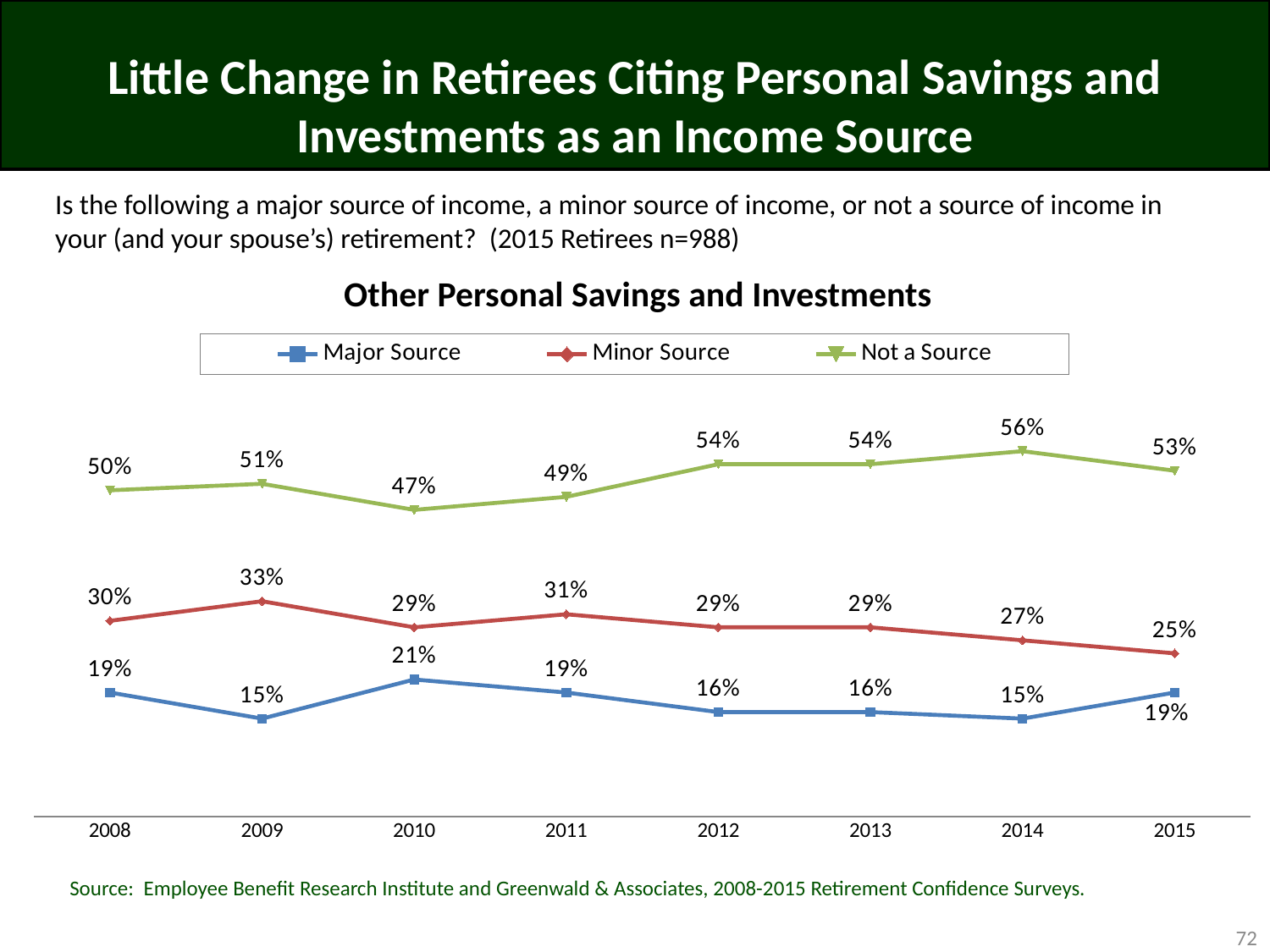
What is the value for Minor Source in 2009? 33% What is the title of the chart? Other Personal Savings and Investments Did the Minor Source series rise or fall from 2011 to 2015? Fall In which year is the Not a Source series at its highest? 2014 How many series does the legend list? 3 What is the difference between the Not a Source and Major Source values in 2015? 34 percentage points Which is larger in 2011: the Minor Source value or the Major Source value? Minor Source What percentage of retirees cited other personal savings and investments as a Major Source in 2010? 21% What is the value for Not a Source in 2014? 56% In which year is the Minor Source series at its lowest? 2015 What kind of chart is shown on the slide? Line chart How many years are shown on the x axis? 8